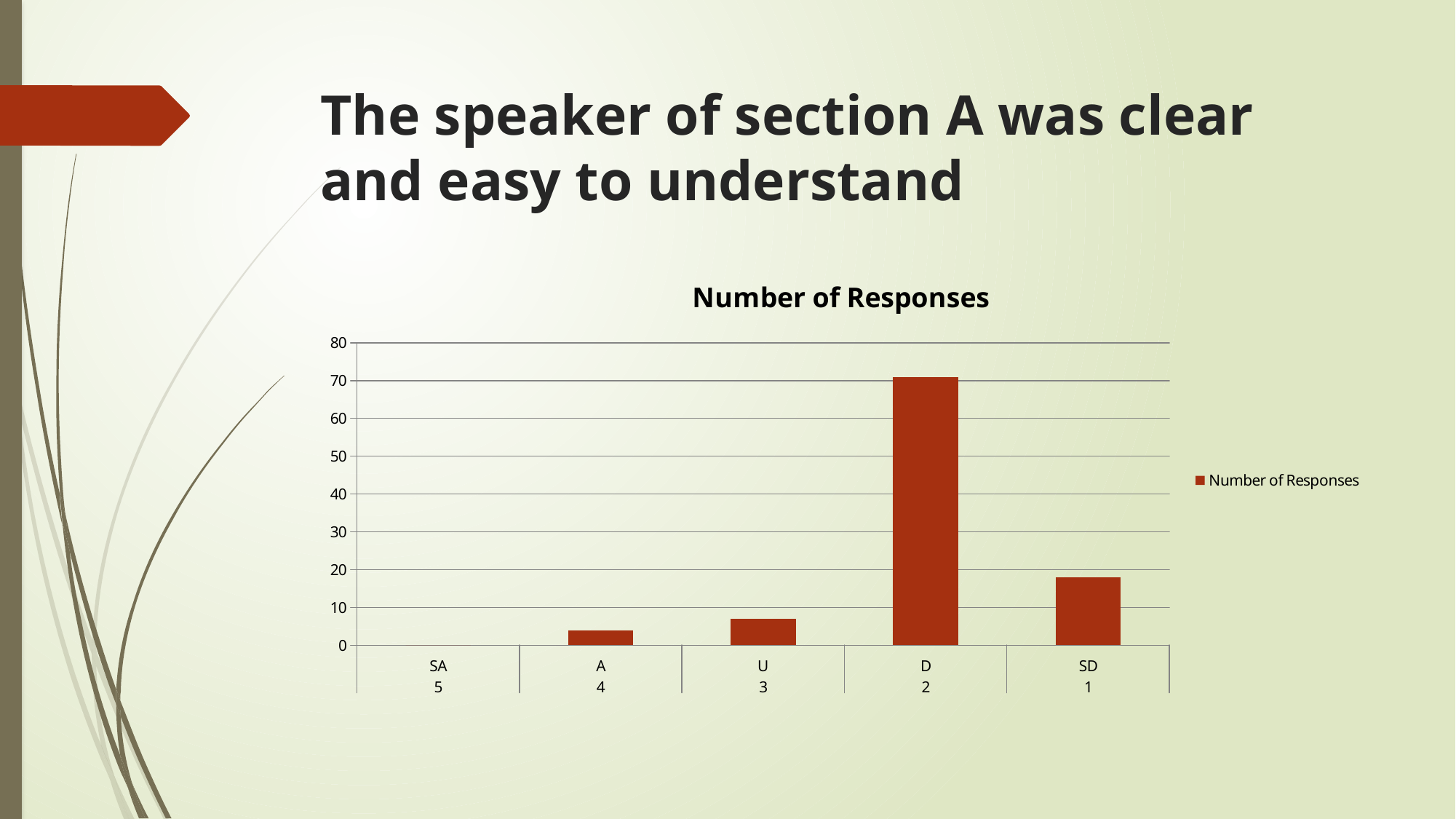
Which has more responses, SD or U? SD Which category has the highest number of responses? D How many series does the chart's legend list? 1 Is the value for SD greater or less than 30? less What kind of chart is shown on the slide? bar chart What is the name of the series shown in the legend? Number of Responses What is the title of the chart? Number of Responses Which has more responses, D or SD? D Which category has the lowest number of responses? SA How many categories are shown on the x axis of the chart? 5 Is the value for D greater or less than 60? greater Is the value for A greater or less than 10? less